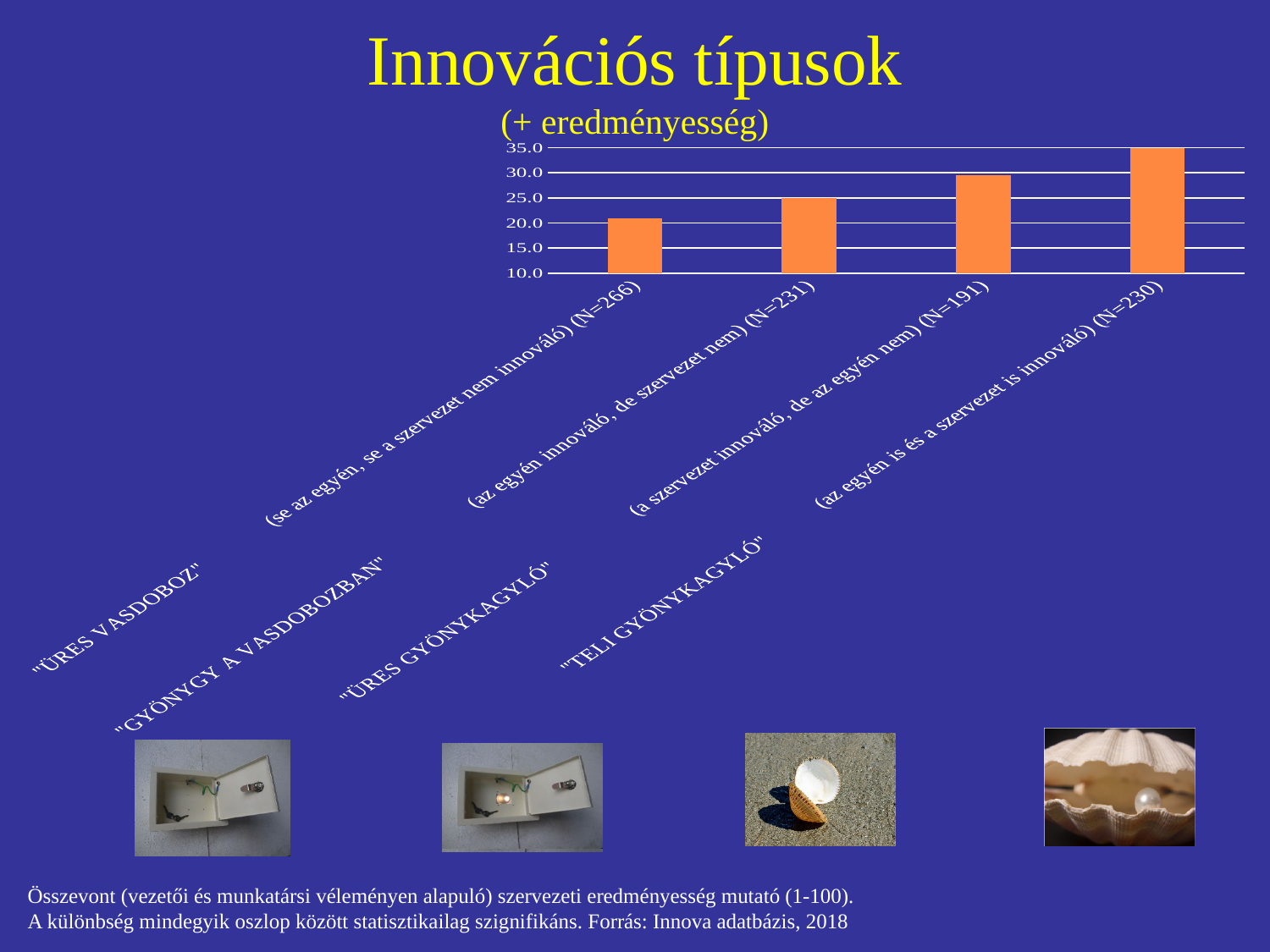
How many bars does the chart show? 4 What is the title of the slide containing the chart? Innovációs típusok Is the value for "TELI GYÖNGYKAGYLÓ" greater or less than 30? greater What is the sample size (N) shown for the "ÜRES VASDOBOZ" category? N=266 Is the value for "ÜRES GYÖNGYKAGYLÓ" greater or less than 25? greater Which category has the highest bar in the chart? "TELI GYÖNYKAGYLÓ" Do the bar values rise or fall from left to right across the chart? rise Which is larger, the value for "GYÖNGY A VASDOBOZBAN" or the value for "TELI GYÖNGYKAGYLÓ"? "TELI GYÖNYKAGYLÓ" Which category has the lowest bar in the chart? "ÜRES VASDOBOZ" Which is larger, the value for "ÜRES VASDOBOZ" or the value for "ÜRES GYÖNGYKAGYLÓ"? "ÜRES GYÖNYKAGYLÓ" What kind of chart is shown on the slide? bar chart Is the value for "ÜRES VASDOBOZ" greater or less than 25? less